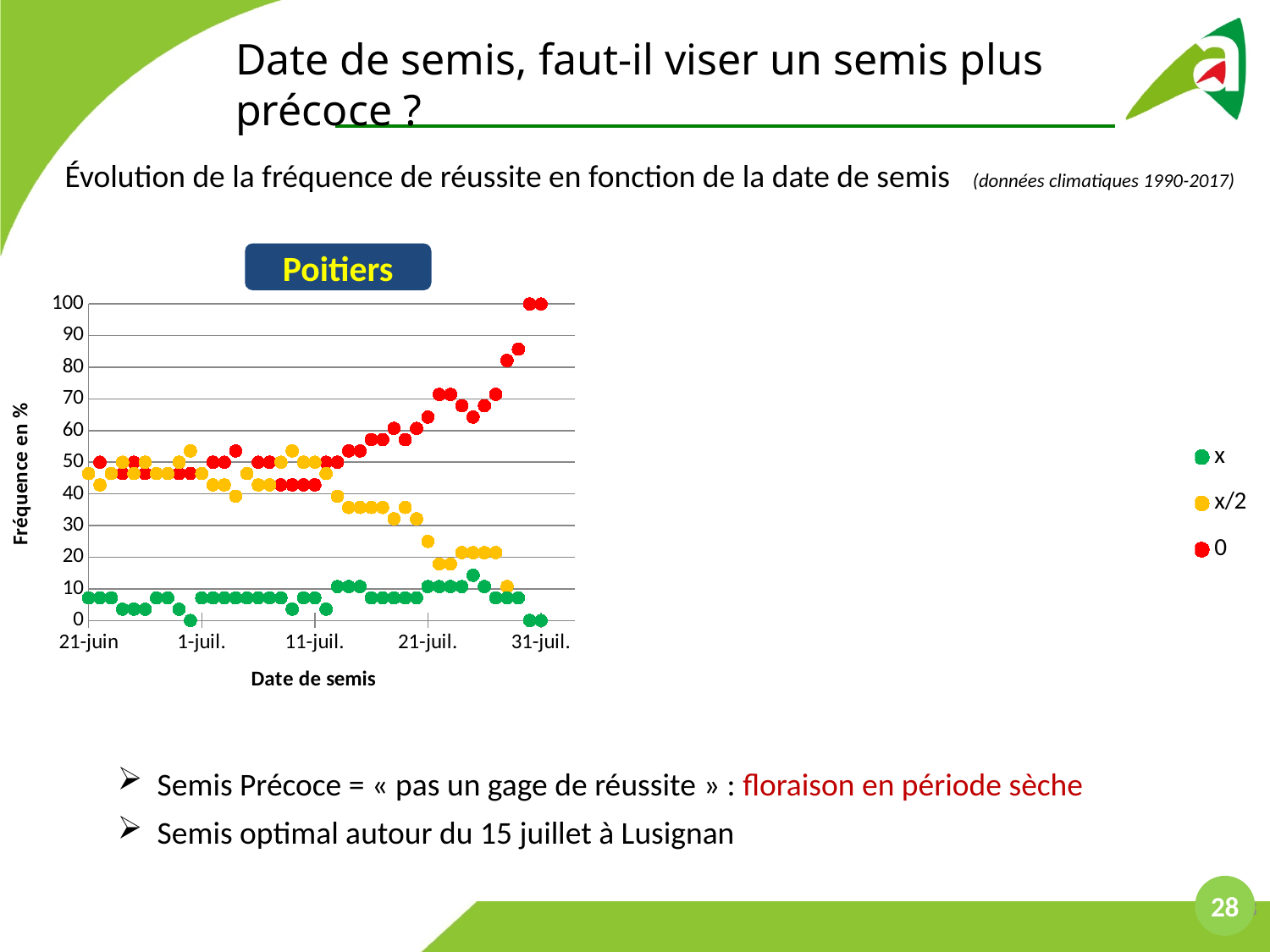
In the Poitiers chart, is the value of series 'x/2' at 21-juil. greater or less than 50? less What are the legend entries of the Poitiers chart? x, x/2, 0 In the Poitiers chart, does the series '0' (red) rise or fall as the sowing date moves from 21-juin to 31-juil.? rise In the Poitiers chart, is the value of series '0' at 31-juil. greater or less than 90? greater In the Poitiers chart, which series has the highest value at 31-juil.? 0 What kind of chart is shown on the slide? scatter chart In the Poitiers chart, does the series 'x/2' (yellow) rise or fall as the sowing date moves from 11-juil. to 31-juil.? fall In the Poitiers chart, is the value of series '0' at 21-juil. greater or less than 50? greater How many series does the legend of the Poitiers chart list? 3 What is the title of the vertical axis of the Poitiers chart? Fréquence en % In the Poitiers chart, which series has the lowest value at 21-juil.? x